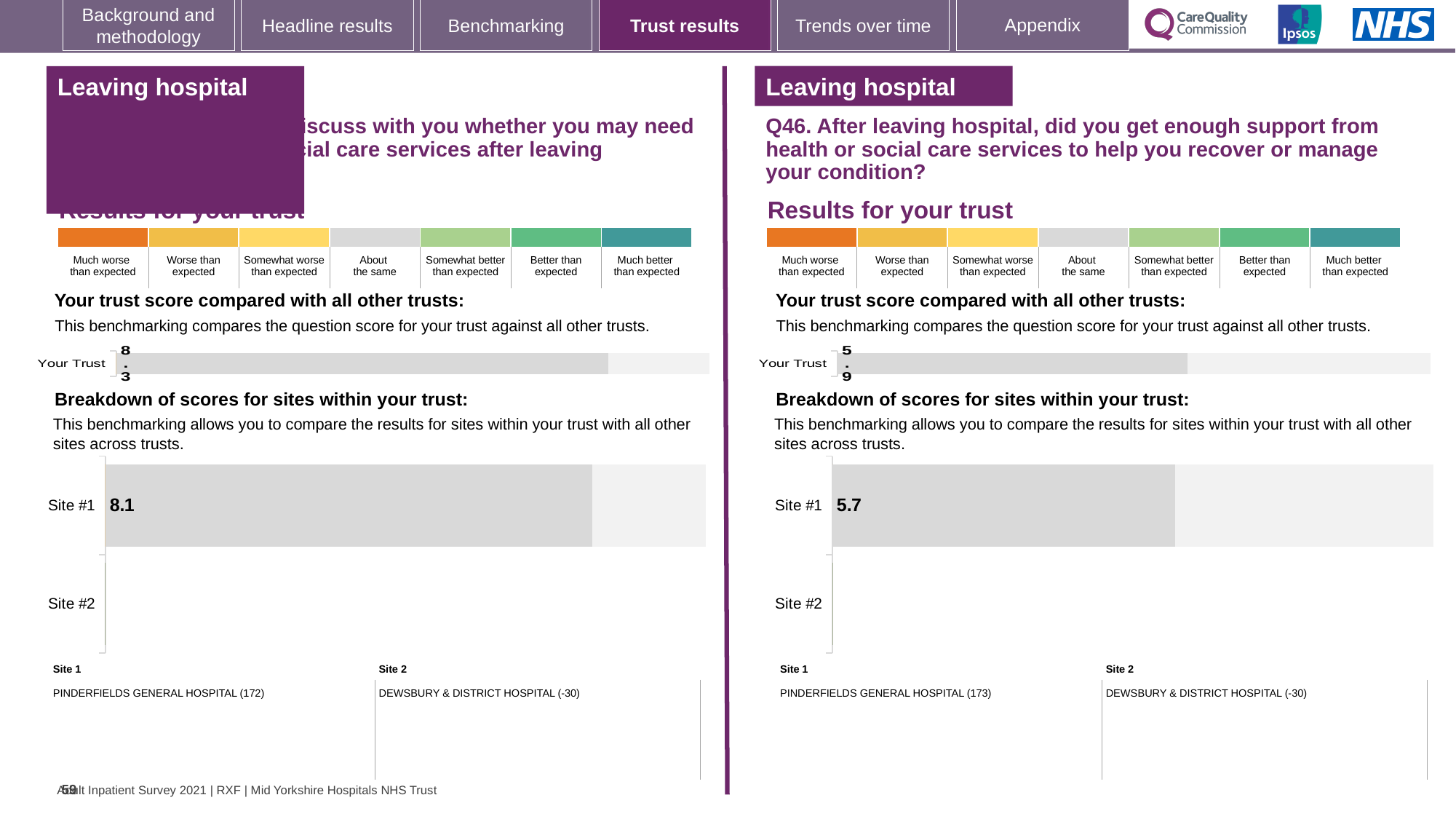
In the right 'Breakdown of scores for sites within your trust' chart (Q46), what is the score for Site #1? 5.7 What is the difference between the Site #1 score in the left breakdown chart and the Site #1 score in the right breakdown chart? 2.4 Which hospital is listed as Site 1 beneath the left breakdown chart? PINDERFIELDS GENERAL HOSPITAL (172) On the right half of the slide (Q46), what is the difference between the Your Trust score and the Site #1 score? 0.2 In the right breakdown chart (Q46), which site has a visible bar with a printed score? Site #1 Which is larger: the Site #1 score in the left breakdown chart or the Site #1 score in the right breakdown chart? Left (8.1) On the left half of the slide, what is the score shown for Your Trust in the 'Your trust score compared with all other trusts' chart? 8.3 What type of chart is used for the 'Breakdown of scores for sites within your trust' on the right half of the slide? Bar chart How many sites are listed in the left 'Breakdown of scores for sites within your trust' chart? 2 On the left half of the slide, what is the difference between the Your Trust score and the Site #1 score? 0.2 In the left 'Breakdown of scores for sites within your trust' chart, what is the score for Site #1? 8.1 On the right half of the slide (Q46), what is the score shown for Your Trust in the 'Your trust score compared with all other trusts' chart? 5.9